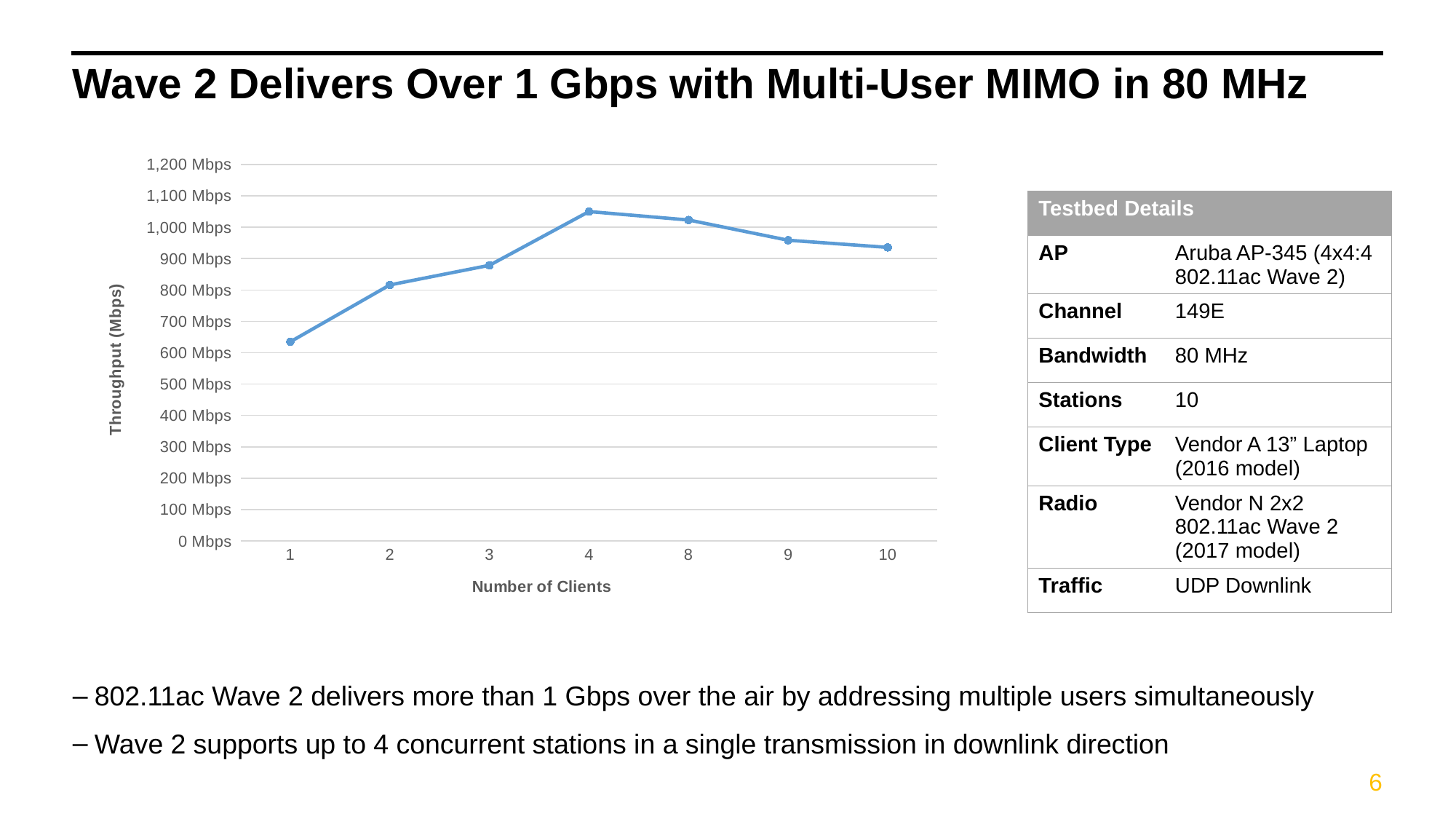
What kind of chart is shown on the slide? Line chart Is the throughput for 2 clients greater or less than 700 Mbps? greater Is the throughput for 4 clients greater or less than 1,000 Mbps? greater Which has higher throughput: 2 clients or 3 clients? 3 clients How many client-count points are plotted on the x axis of the chart? 7 Which has higher throughput: 1 client or 10 clients? 10 clients At which number of clients is throughput highest? 4 Is the throughput for 1 client greater or less than 700 Mbps? less At which number of clients is throughput lowest? 1 How does throughput change as the number of clients increases from 1 to 4? It rises What is the label of the y axis of the chart? Throughput (Mbps)